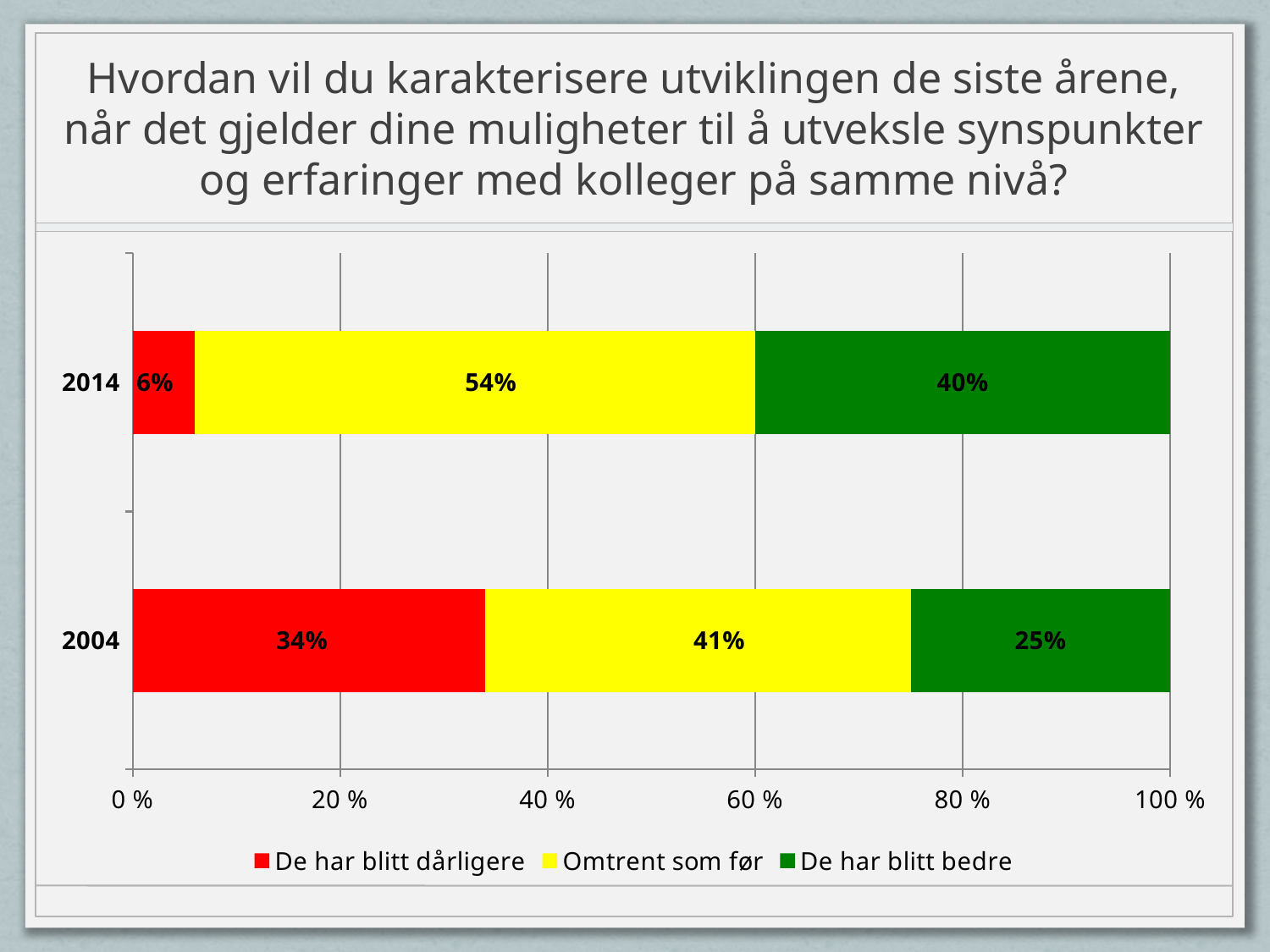
Which year has the higher value for "De har blitt dårligere"? 2004 What is the value for "De har blitt dårligere" in 2004? 34% How many series does the legend list? 3 What is the value for "Omtrent som før" in 2004? 41% Which segment is the largest in the 2014 bar? Omtrent som før What is the difference between the "De har blitt dårligere" values for 2004 and 2014? 28% What kind of chart is shown on the slide? Stacked bar chart Which colour represents "De har blitt bedre" in the chart? Green What is the value for "De har blitt bedre" in 2014? 40% What is the difference between the "De har blitt bedre" values for 2014 and 2004? 15% How many years (categories) are shown on the chart? 2 What is the value for "Omtrent som før" in 2014? 54%